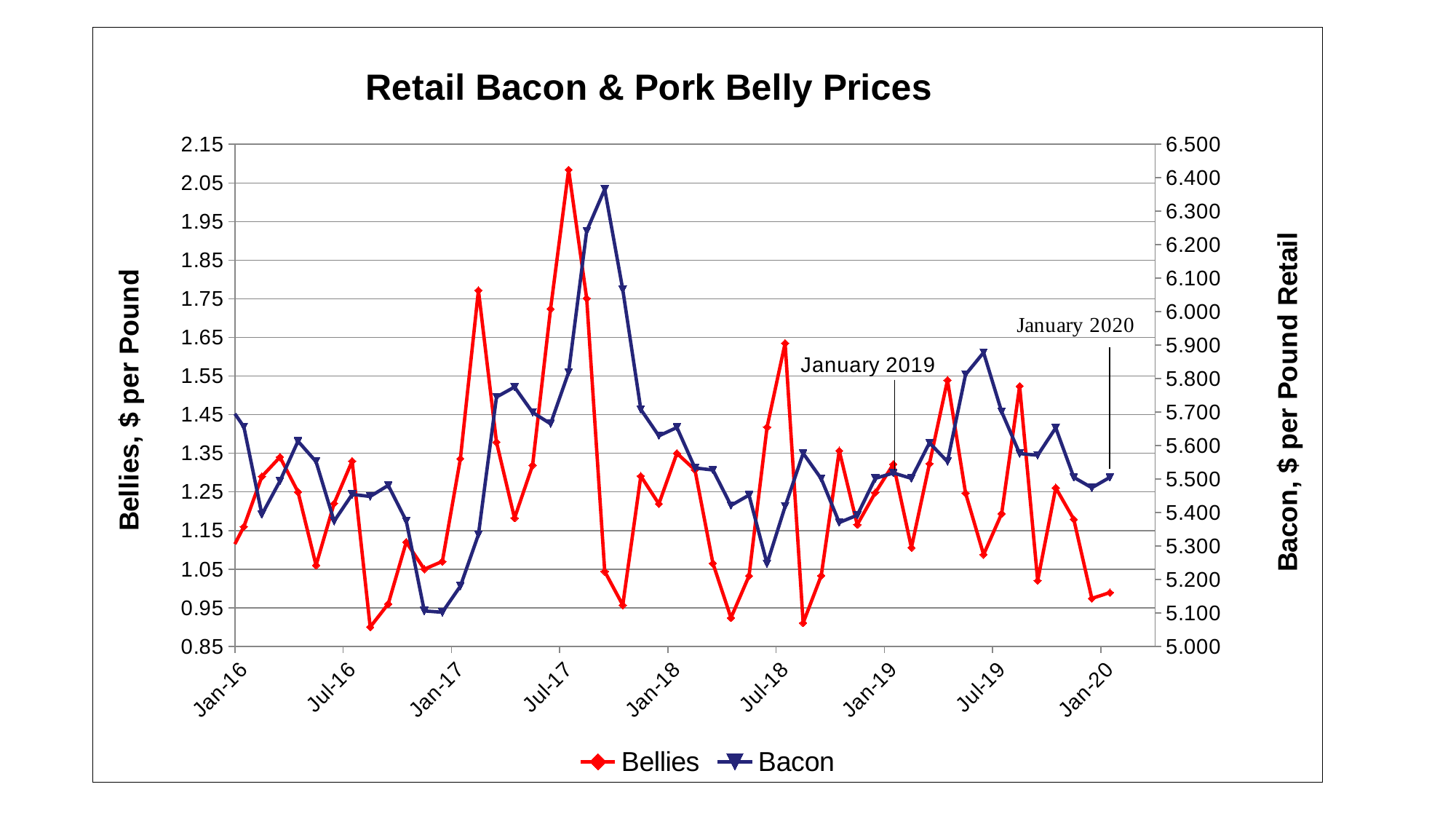
Is the lowest value of the Bacon series greater or less than 5.200? less What kind of chart is shown on the slide? Line chart How many series does the legend list? 2 Is the Bellies value at Jan-20 greater or less than 1.05? less Is the highest value of the Bellies series greater or less than 1.95? greater How many date labels are shown along the x axis? 9 Between Jan-17 and Jul-17, does the Bellies line rise or fall overall? rise What is the title of the chart? Retail Bacon & Pork Belly Prices Between Jul-19 and Jan-20, does the Bellies line rise or fall overall? fall What is the label on the right-hand vertical axis? Bacon, $ per Pound Retail